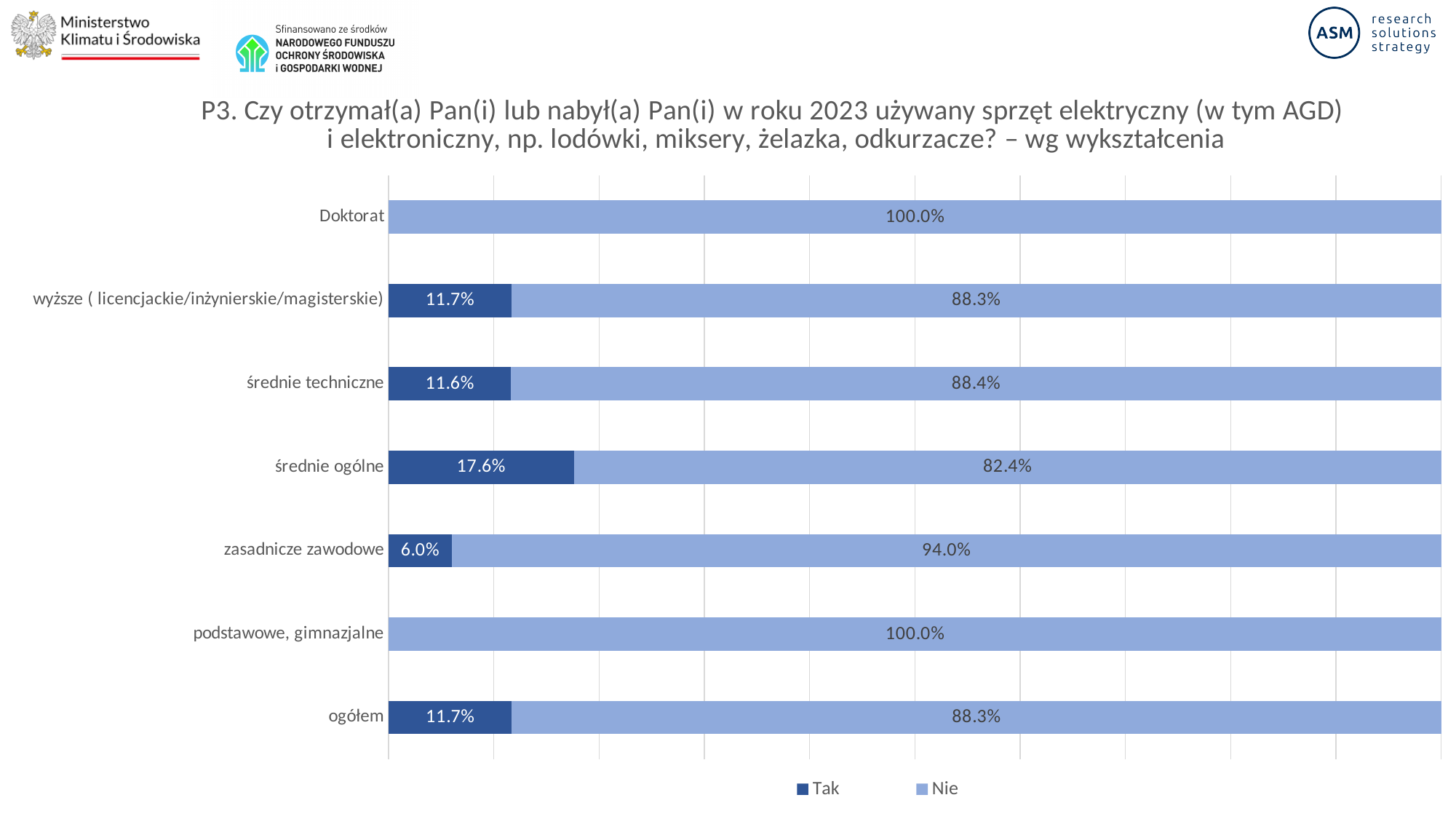
Which education category has the highest "Tak" value? średnie ogólne What is the "Tak" value for ogółem? 11.7% What is the "Nie" value for zasadnicze zawodowe? 94.0% What kind of chart is shown on the slide? Stacked bar chart What is the "Nie" value for Doktorat? 100.0% How many education categories are shown on the chart? 7 Which has a larger "Nie" value: zasadnicze zawodowe or średnie ogólne? zasadnicze zawodowe What is the difference between the "Tak" values for średnie ogólne and zasadnicze zawodowe? 11.6 percentage points Among categories with a printed "Tak" value, which has the lowest? zasadnicze zawodowe What is the total of the stacked bar for wyższe (licencjackie/inżynierskie/magisterskie)? 100.0% How many series does the legend list? 2 What is the "Tak" value for średnie ogólne? 17.6%